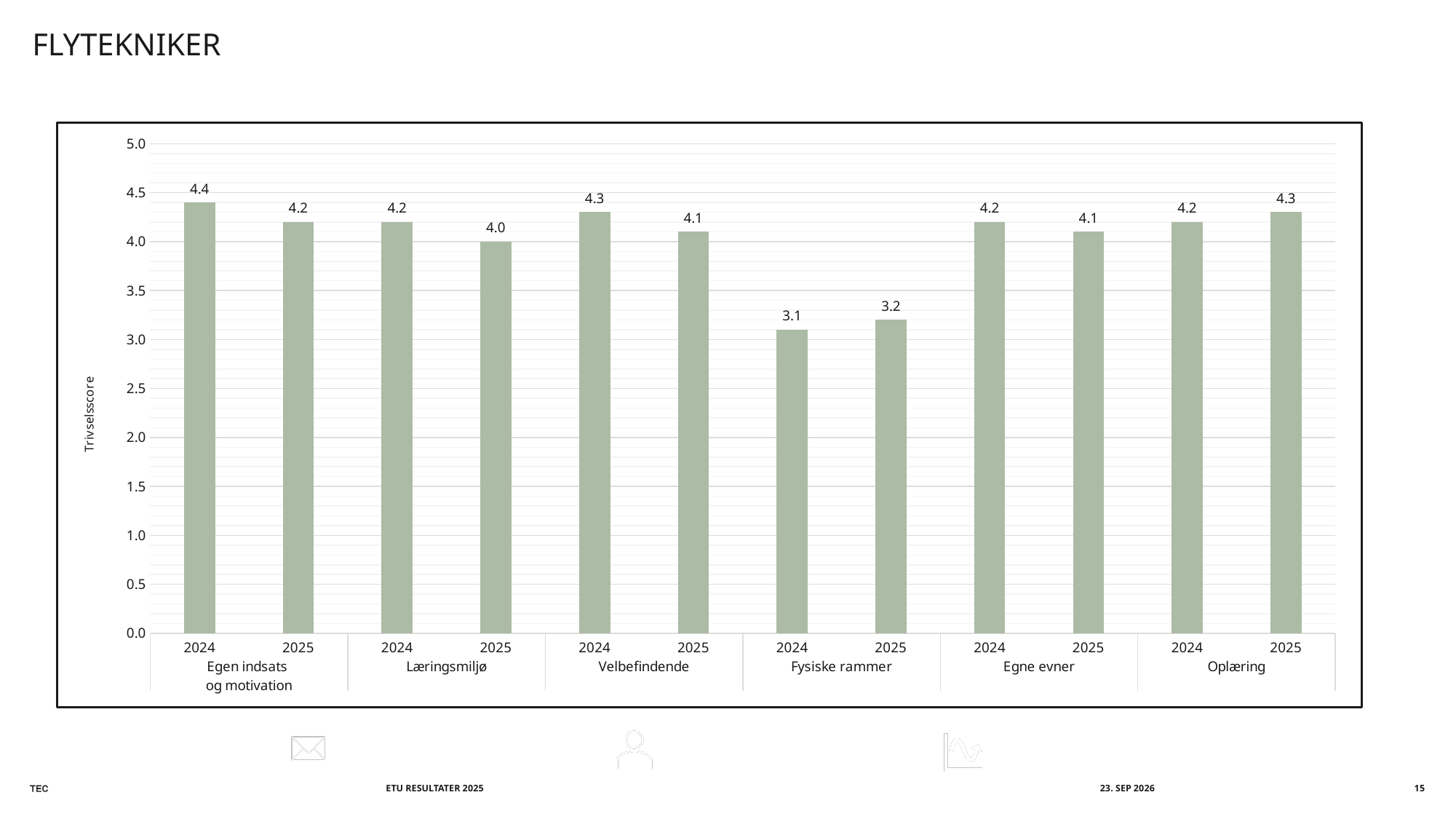
How many bars are plotted in the chart? 12 What is the value for Læringsmiljø in 2025? 4.0 What is the value for Oplæring in 2025? 4.3 Which is larger, the 2024 value for Egne evner or the 2025 value for Egne evner? 2024 Which bar has the lowest value in the chart? Fysiske rammer 2024 What is the value for Fysiske rammer in 2025? 3.2 What is the label on the vertical axis of the chart? Trivselsscore Which bar has the highest value in the chart? Egen indsats og motivation 2024 Is the 2024 value for Fysiske rammer greater or less than 3.5? less What kind of chart is shown on the slide? bar chart What is the difference between the 2024 and 2025 values for Velbefindende? 0.2 What is the value for Egen indsats og motivation in 2024? 4.4